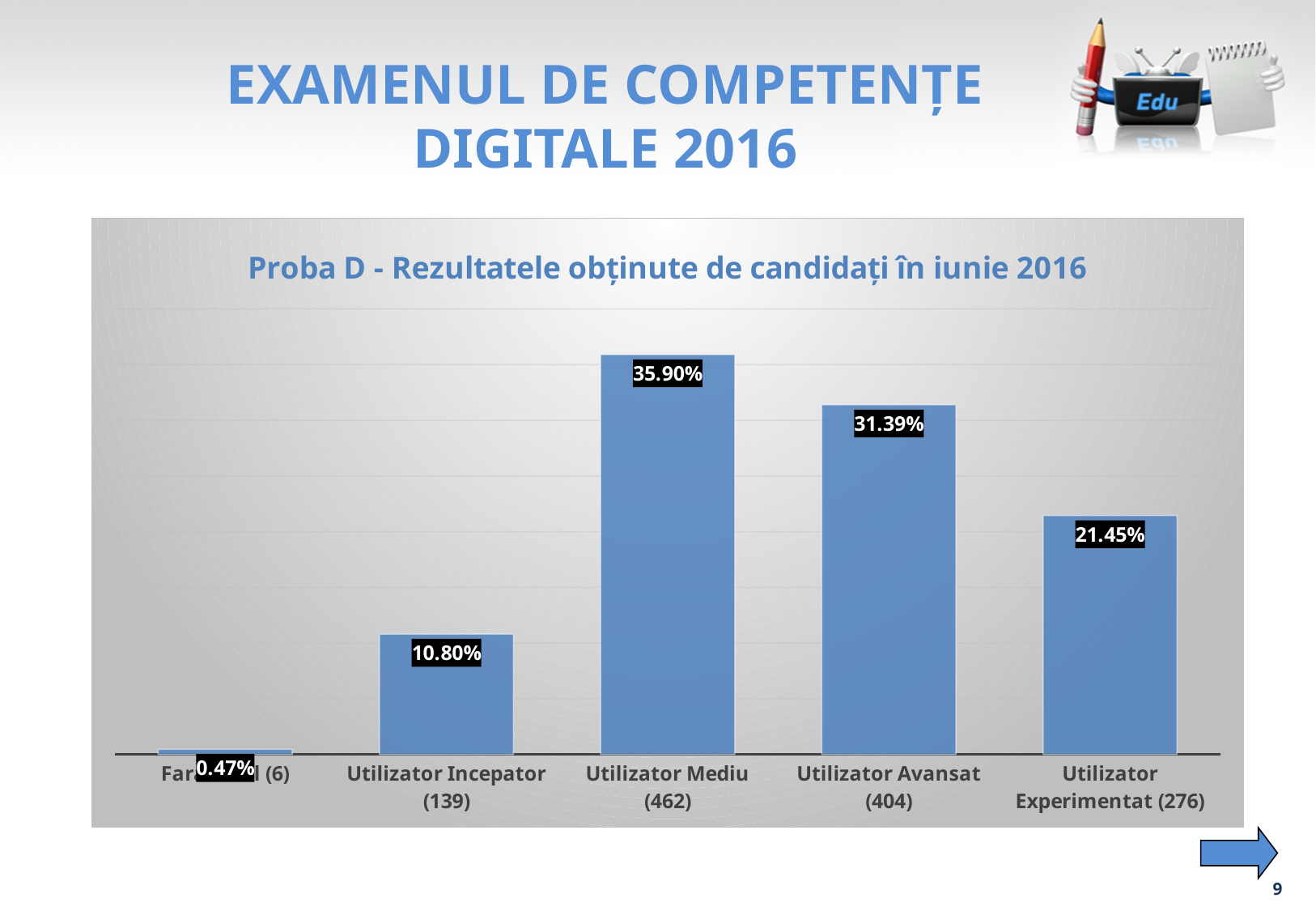
Which has a larger percentage, Utilizator Avansat (404) or Utilizator Experimentat (276)? Utilizator Avansat (404) What is the difference between the percentages for Utilizator Experimentat (276) and Utilizator Incepator (139)? 10.65% What percentage is shown for Utilizator Incepator (139)? 10.80% What type of chart is shown on the slide? Bar chart What percentage is shown for Utilizator Avansat (404)? 31.39% What percentage is shown for Utilizator Experimentat (276)? 21.45% How many categories are shown in the chart? 5 What is the title of the chart? Proba D - Rezultatele obținute de candidați în iunie 2016 What is the data label on the leftmost bar of the chart? 0.47% What percentage is shown for Utilizator Mediu (462)? 35.90% Which category has the highest percentage? Utilizator Mediu (462) What is the difference between the percentages for Utilizator Mediu (462) and Utilizator Avansat (404)? 4.51%